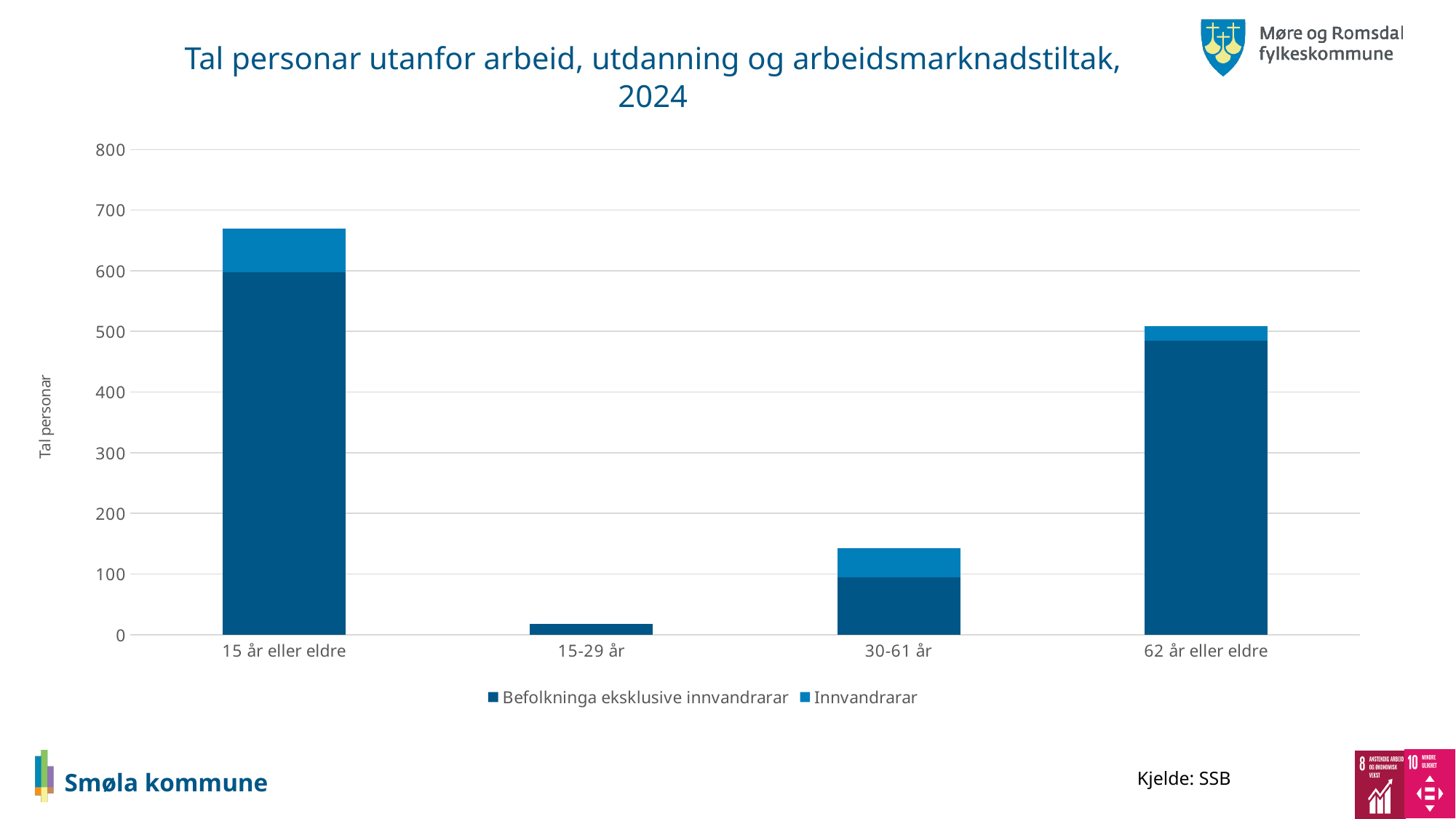
Is the total stacked value for 30-61 år greater or less than 100? greater How many series does the legend list? 2 How many age categories are shown on the x axis? 4 Which category has the shortest stacked bar? 15-29 år Which category has the tallest stacked bar? 15 år eller eldre Is the total stacked value for 15 år eller eldre greater or less than 600? greater Which has a taller stacked bar, 30-61 år or 62 år eller eldre? 62 år eller eldre What is the label on the y axis? Tal personar What kind of chart is shown on the slide? Bar chart Is the total stacked value for 62 år eller eldre greater or less than 600? less What is the title of the chart? Tal personar utanfor arbeid, utdanning og arbeidsmarknadstiltak, 2024